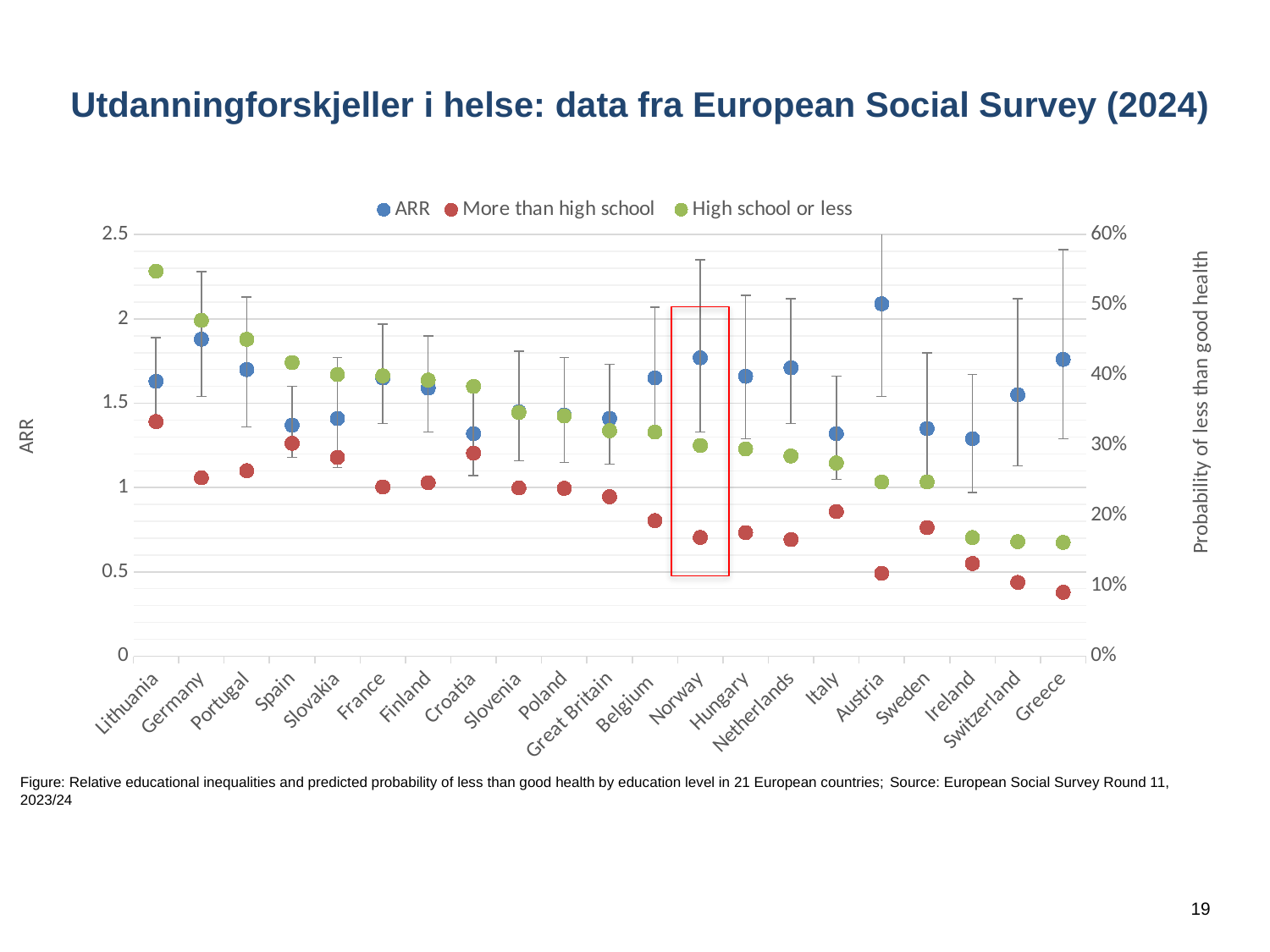
How many series does the chart legend list? 3 Do the 'High school or less' values generally rise or fall moving from Lithuania on the left to Greece on the right? fall Which country has the highest value for the 'More than high school' series? Lithuania What kind of chart is shown on the slide? Scatter (dot) chart Which country is highlighted with a red box on the chart? Norway Is the 'High school or less' value for Lithuania greater or less than 50%? greater Is the ARR value for Austria greater or less than 2? greater Which has the larger ARR value, Germany or Spain? Germany How many countries are shown on the x axis of the chart? 21 Is the 'High school or less' value for Ireland greater or less than 20%? less Which country has the highest value for the 'High school or less' series? Lithuania Which country has the highest ARR value? Austria